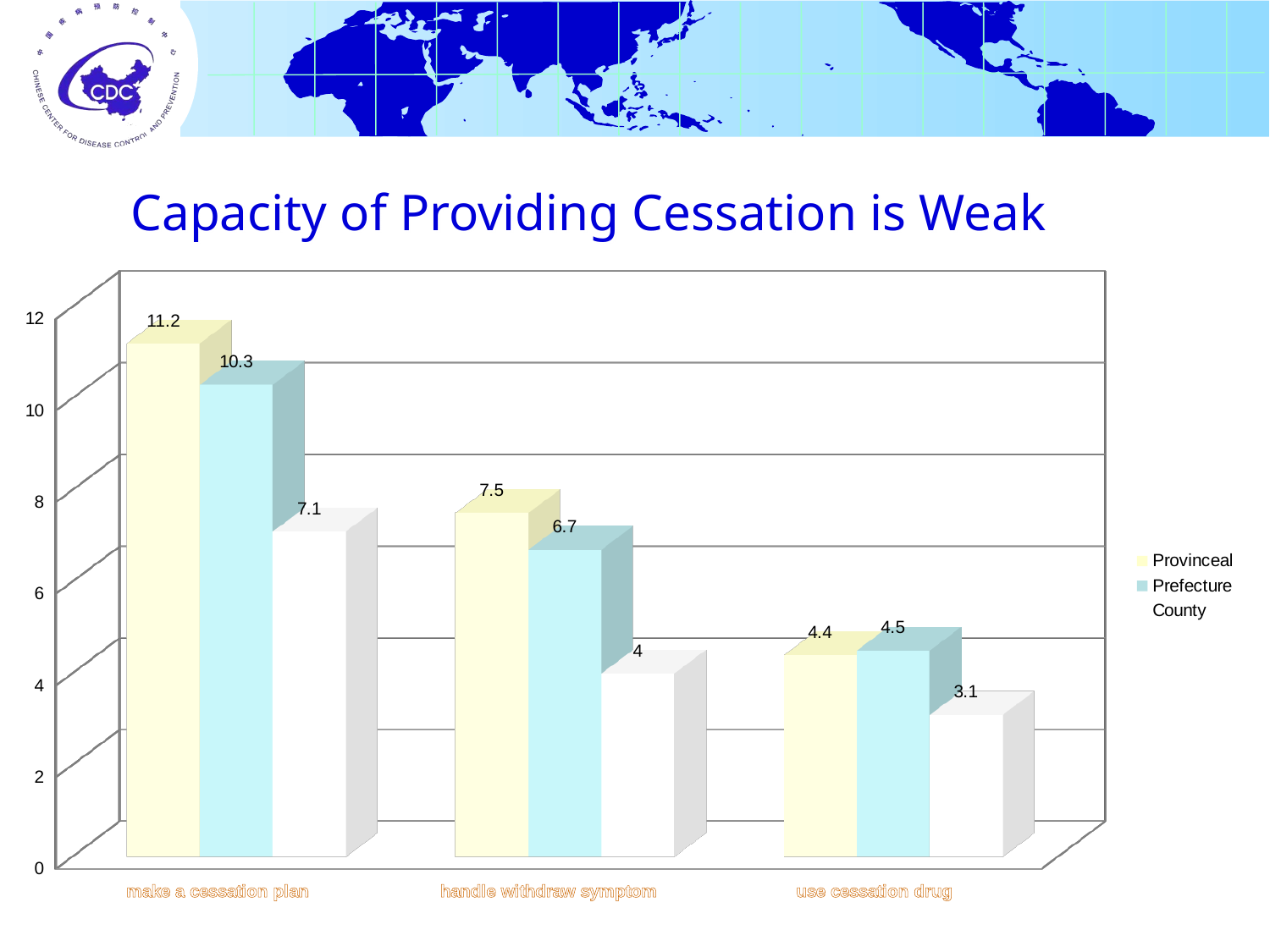
What is the Provinceal value for "make a cessation plan"? 11.2 What is the title of the slide? Capacity of Providing Cessation is Weak Which category has the highest Provinceal value? make a cessation plan What is the difference between the Provinceal and County values for "make a cessation plan"? 4.1 How many categories are shown on the x axis? 3 Which is larger for "handle withdraw symptom": the Provinceal value or the Prefecture value? Provinceal Do the Prefecture values rise or fall from "make a cessation plan" to "use cessation drug"? Fall What is the Prefecture value for "use cessation drug"? 4.5 What is the County value for "handle withdraw symptom"? 4 How many series does the legend list? 3 Which category has the lowest County value? use cessation drug What kind of chart is shown on the slide? Bar chart